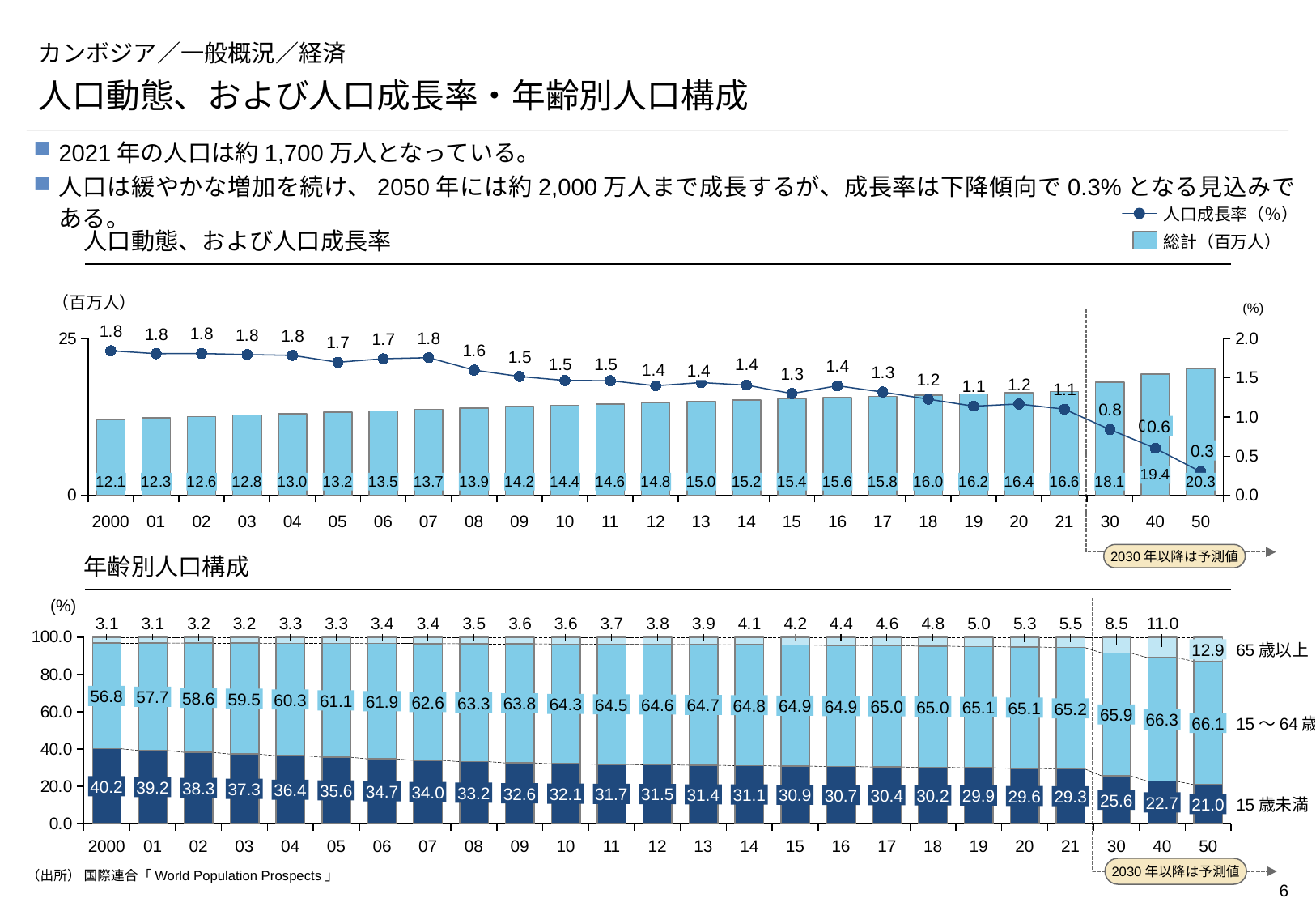
In the top chart (人口動態、および人口成長率), which year has the lowest population growth rate? 50 In the top chart (人口動態、および人口成長率), which year has the highest total population bar? 50 In the top chart (人口動態、および人口成長率), what is the population growth rate (%) shown for 50? 0.3 In the bottom chart (年齢別人口構成), what is the value for 15歳未満 in 2000? 40.2 What kind of chart is the bottom chart (年齢別人口構成)? stacked bar chart In the bottom chart (年齢別人口構成), is the 15～64歳 value larger in 2000 or in 21? 21 In the top chart (人口動態、および人口成長率), does the population growth rate line generally rise or fall from 2000 to 50? fall In the top chart (人口動態、および人口成長率), how many series does the legend list? 2 In the bottom chart (年齢別人口構成), what is the value for 65歳以上 in 50? 12.9 In the top chart (人口動態、および人口成長率), what is the total population (百万人) shown for 21? 16.6 In the top chart (人口動態、および人口成長率), what is the difference between the total population for 50 and for 2000? 8.2 In the bottom chart (年齢別人口構成), how many years are shown on the x axis? 25